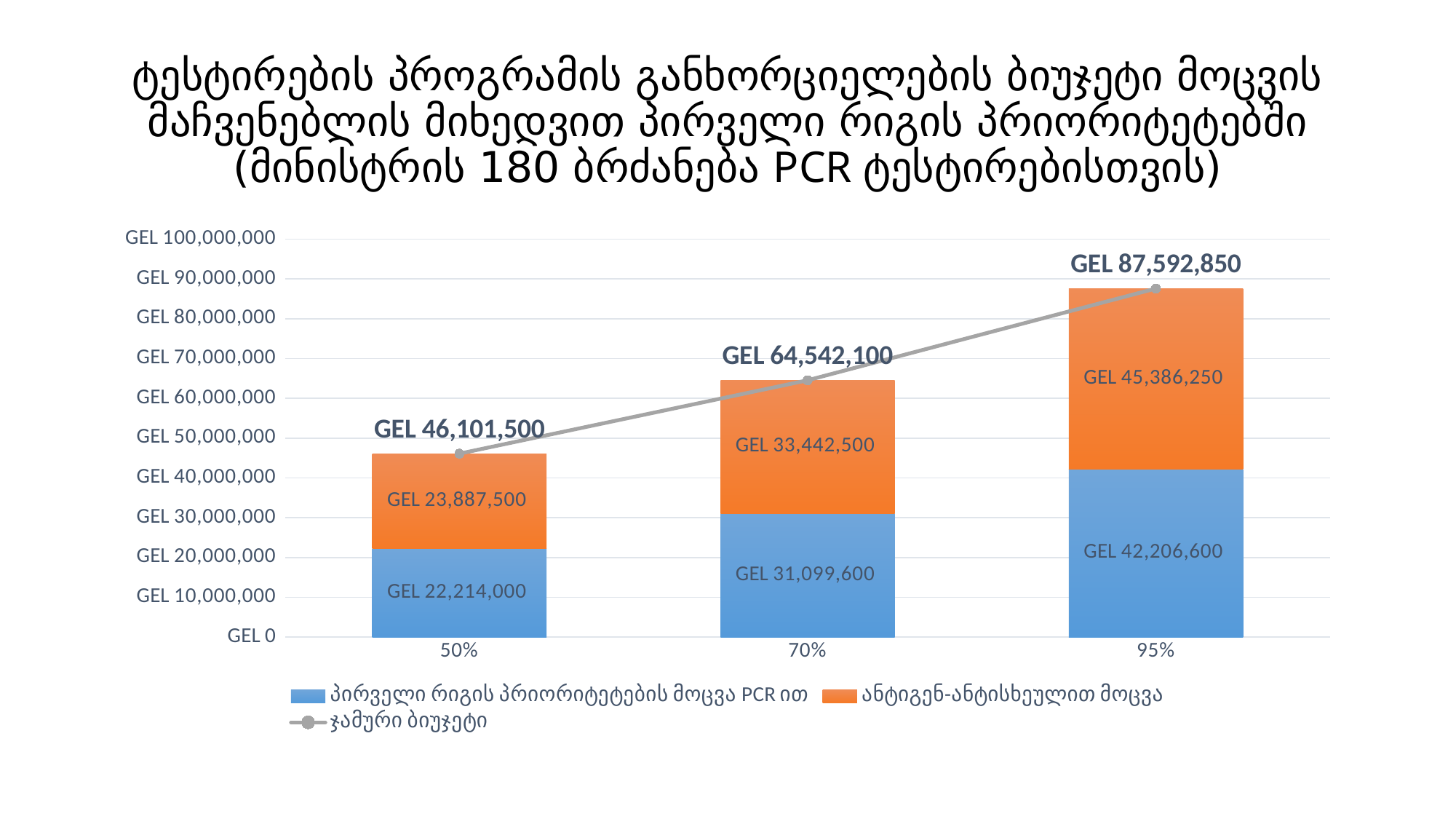
What is the value of the orange series (ანტიგენ-ანტისხეულით მოცვა) for the 70% category? GEL 33,442,500 Which is larger for the 95% category: the blue series (PCR) or the orange series (ანტიგენ-ანტისხეულით მოცვა)? The orange series (ანტიგენ-ანტისხეულით მოცვა) How many categories are shown on the x axis of the chart? 3 What is the value of the blue series (პირველი რიგის პრიორიტეტების მოცვა PCR ით) for the 50% category? GEL 22,214,000 Which category has the lowest value for the blue series (პირველი რიგის პრიორიტეტების მოცვა PCR ით)? 50% What type of chart is shown on the slide? Stacked bar chart with a line What is the difference between the total budget for 95% and the total budget for 50%? GEL 41,491,350 What is the total budget (ჯამური ბიუჯეტი) shown for the 95% category? GEL 87,592,850 Which category has the highest total budget? 95% What is the total of the stacked bar for the 70% category? GEL 64,542,100 Do the total budget values rise or fall as the coverage percentage increases along the x axis? Rise How many series does the chart legend list? 3